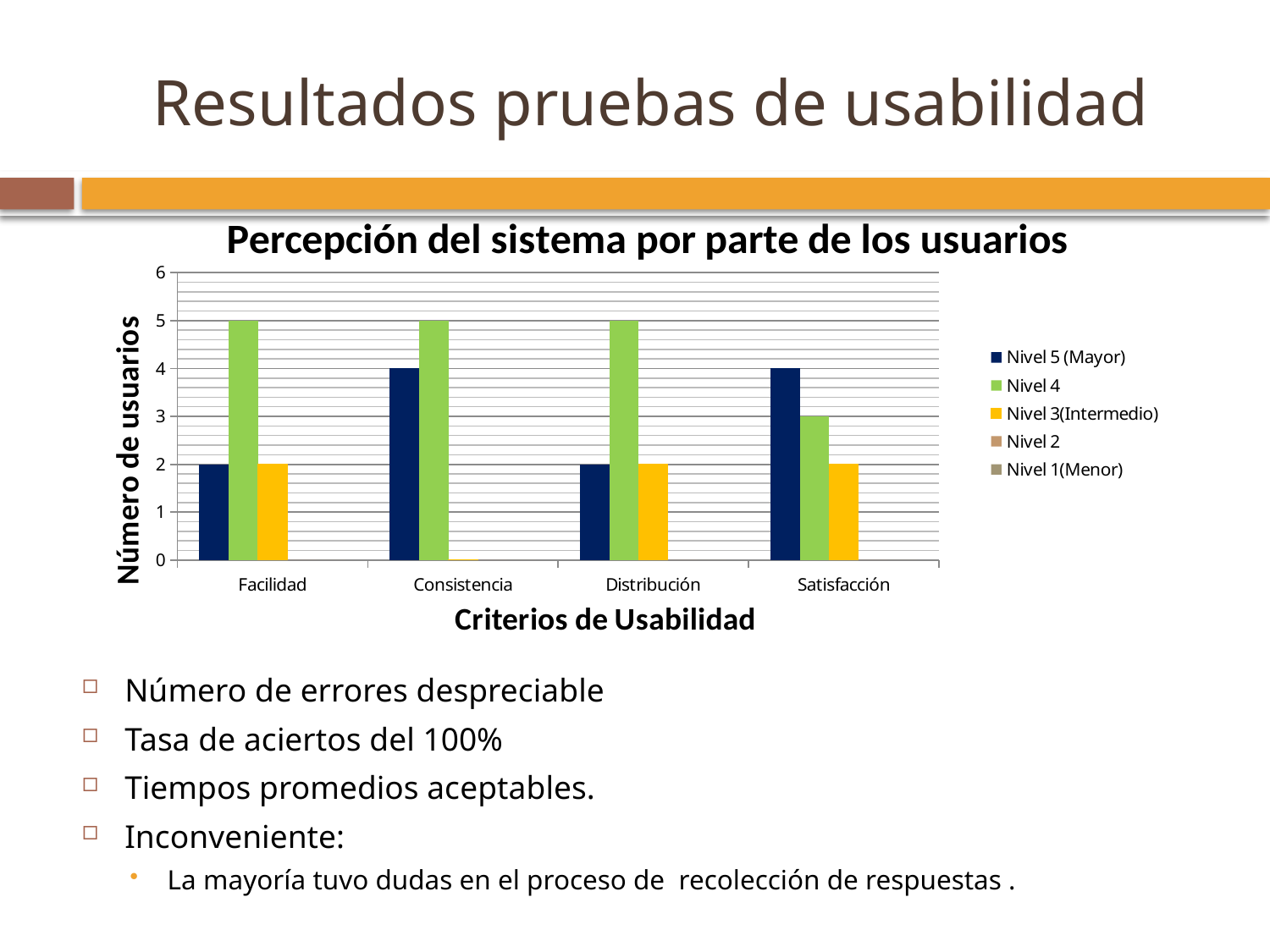
What kind of chart is shown on the slide? bar chart What is the title of the chart? Percepción del sistema por parte de los usuarios What is the difference between the Nivel 4 and Nivel 5 (Mayor) values for Facilidad? 3 What is the value of Nivel 5 (Mayor) for Consistencia? 4 Which category has the lowest Nivel 4 value? Satisfacción What is the value of Nivel 3(Intermedio) for Distribución? 2 What is the value of Nivel 4 for Facilidad? 5 How many series does the chart legend list? 5 What is the label of the y axis? Número de usuarios How many usability criteria (categories) are shown on the x axis? 4 What is the value of Nivel 4 for Satisfacción? 3 Which is larger for Satisfacción, Nivel 5 (Mayor) or Nivel 4? Nivel 5 (Mayor)